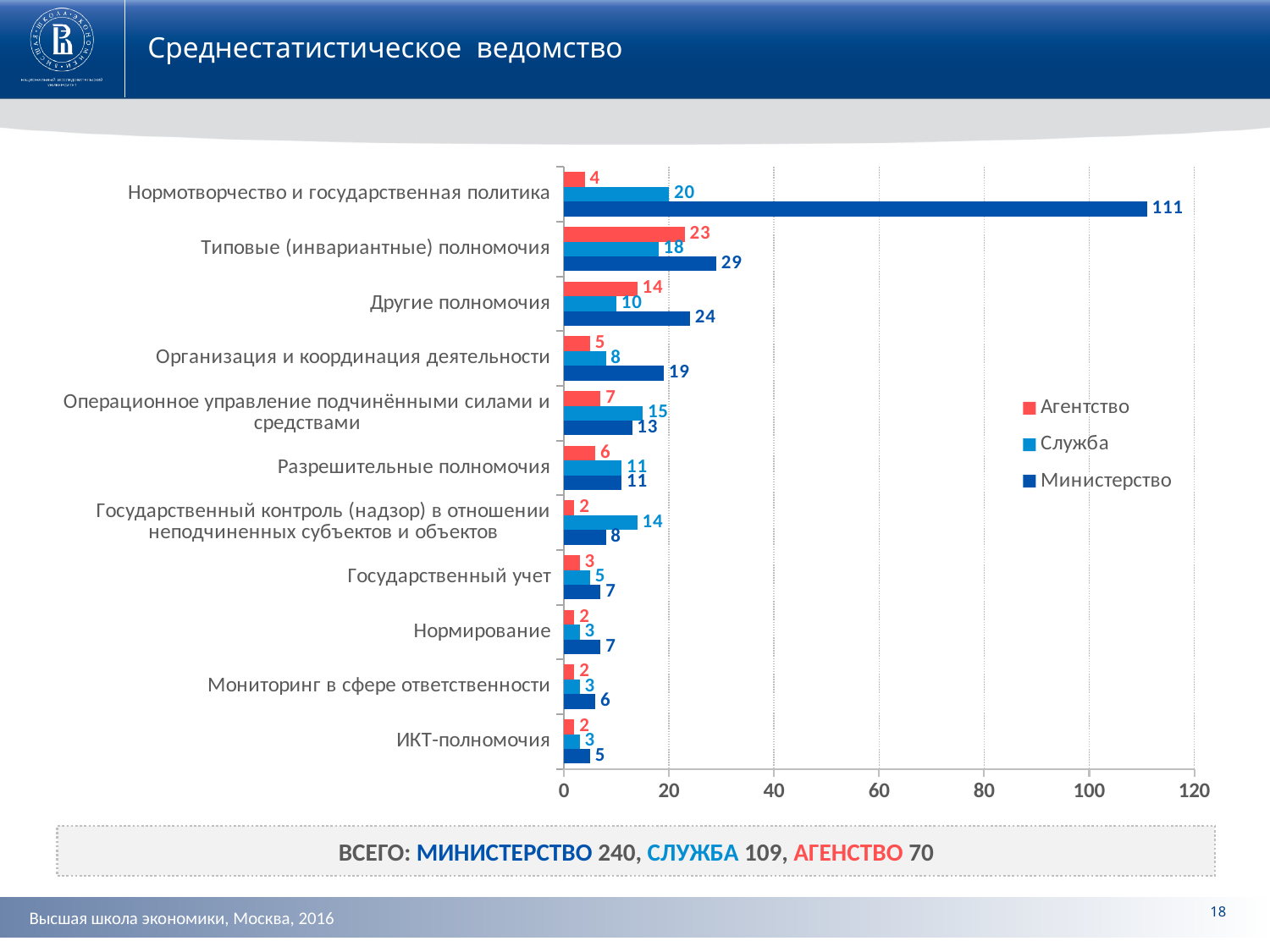
How many categories are shown on the chart? 11 In the category Операционное управление подчинёнными силами и средствами, which is larger: the Служба value or the Министерство value? Служба Which colour represents the Агентство series in the chart? Red What is the value for Агентство in the category Типовые (инвариантные) полномочия? 23 Which category has the highest value for Министерство? Нормотворчество и государственная политика What kind of chart is shown on the slide? Bar chart What is the difference between the Министерство and Служба values in the category Нормотворчество и государственная политика? 91 What is the value for Служба in the category Государственный контроль (надзор) в отношении неподчиненных субъектов и объектов? 14 What is the value for Министерство in the category Нормотворчество и государственная политика? 111 Is the value for Министерство in the category Типовые (инвариантные) полномочия greater or less than 20? greater Which category has the lowest value for Министерство? ИКТ-полномочия How many series does the legend list? 3